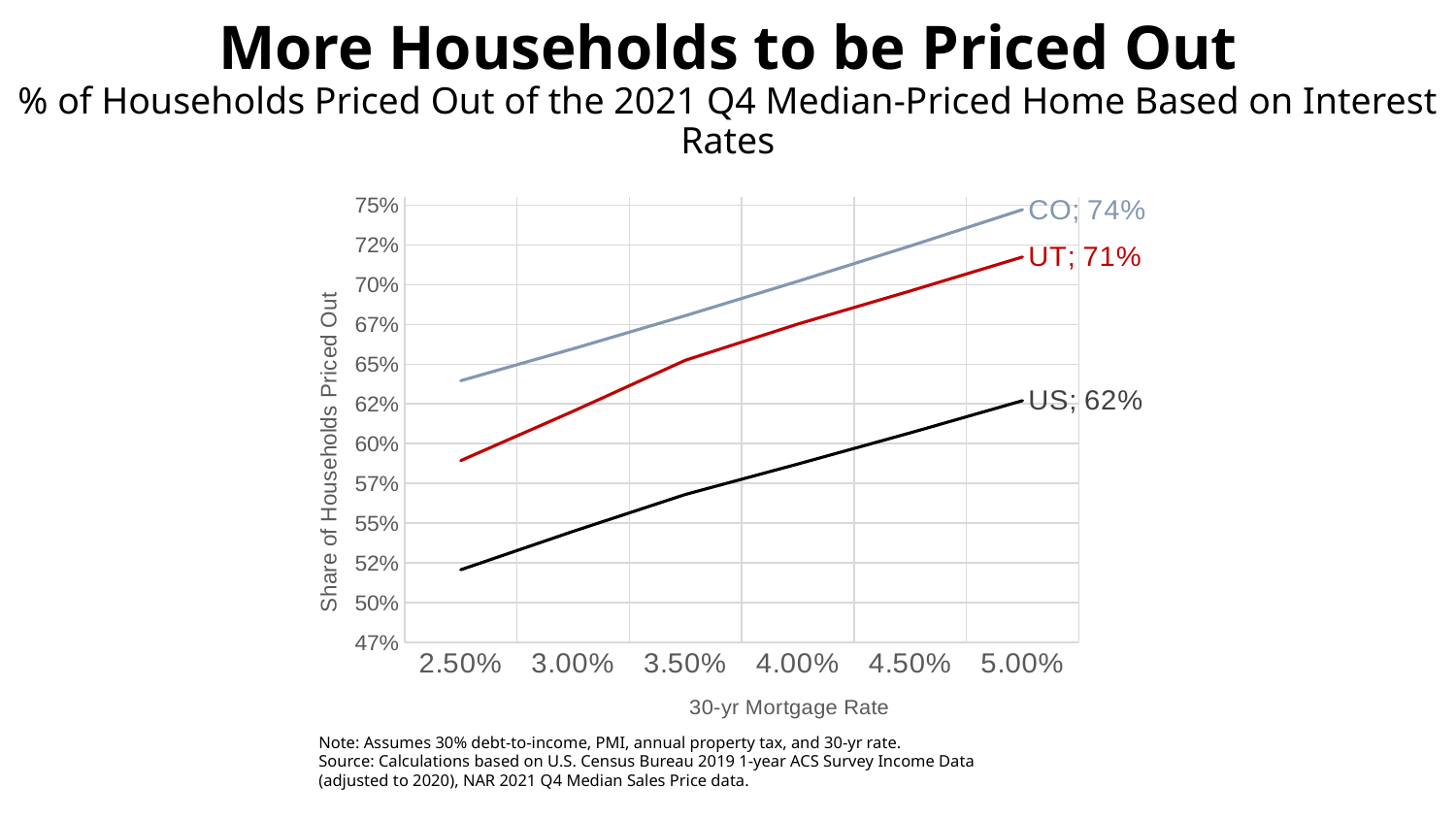
What is the difference between the CO and US values at a 5.00% mortgage rate? 12 percentage points At a 5.00% mortgage rate, which is larger, the UT value or the US value? UT Is the value for US at a 2.50% mortgage rate greater or less than 55%? less Do the values rise or fall as the 30-yr mortgage rate increases? Rise Which series has the highest share of households priced out at a 5.00% mortgage rate? CO What is the value for US at a 5.00% mortgage rate? 62% Which series has the lowest share of households priced out at a 5.00% mortgage rate? US What is the value for CO at a 5.00% mortgage rate? 74% What kind of chart is shown on the slide? Line chart How many series are plotted on the chart? 3 What is the value for UT at a 5.00% mortgage rate? 71% Is the value for CO at a 2.50% mortgage rate greater or less than 60%? greater